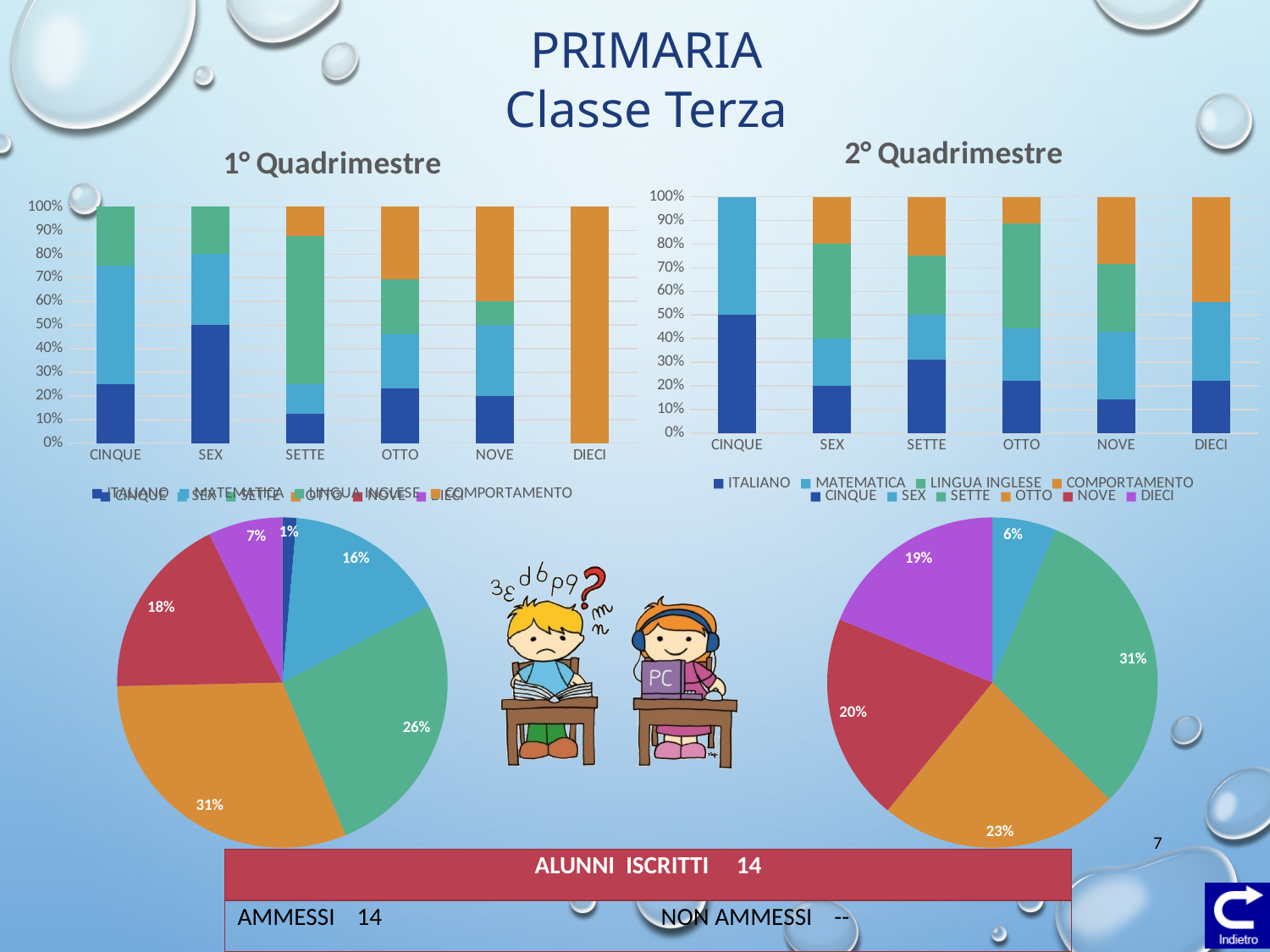
In the 1° Quadrimestre chart, what kind of chart is shown? stacked bar chart In the left pie chart, how many slices are there? 6 In the right pie chart, what is the smallest slice's percentage? 6% In the 2° Quadrimestre chart, how many series does the legend list? 4 In the 1° Quadrimestre chart, is the ITALIANO share for SETTE greater or less than 20%? less In the left pie chart, what is the largest slice's percentage? 31% In the right pie chart, what is the difference between the largest slice (31%) and the 23% slice? 8 percentage points In the 1° Quadrimestre chart, which has the larger ITALIANO share, SEX or SETTE? SEX In the left pie chart, what is the smallest slice's percentage? 1% In the 2° Quadrimestre chart, how many categories are shown on the x axis? 6 In the 2° Quadrimestre chart, is the ITALIANO share for SETTE greater or less than 20%? greater What is the title of the bar chart on the left of the slide? 1° Quadrimestre